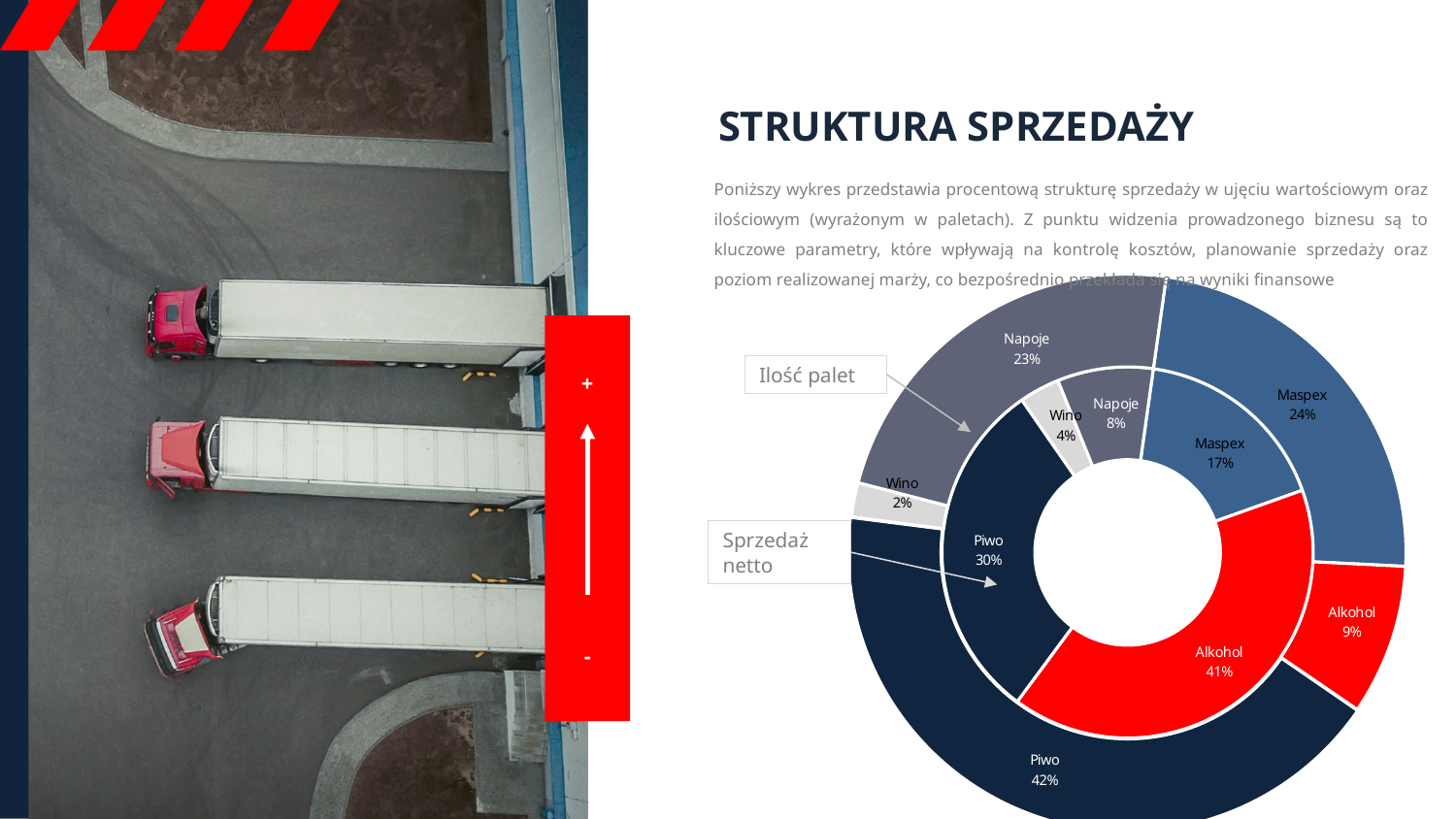
What is the difference between the Alkohol share in Sprzedaż netto (41%) and in Ilość palet (9%)? 32 percentage points In the inner ring (Sprzedaż netto), what share does Napoje have? 8% What type of chart is shown on the slide? Doughnut chart What is the title of the slide containing the chart? STRUKTURA SPRZEDAŻY In the outer ring (Ilość palet), what share does Maspex have? 24% What are the two rings of the chart labelled? Ilość palet and Sprzedaż netto Which category has the largest share in the outer ring (Ilość palet)? Piwo In the outer ring (Ilość palet), what share does Piwo have? 42% Which is larger: the Napoje share in Ilość palet or the Napoje share in Sprzedaż netto? Ilość palet How many categories are shown in each ring of the chart? 5 Which category has the smallest share in the inner ring (Sprzedaż netto)? Wino In the inner ring (Sprzedaż netto), what share does Alkohol have? 41%